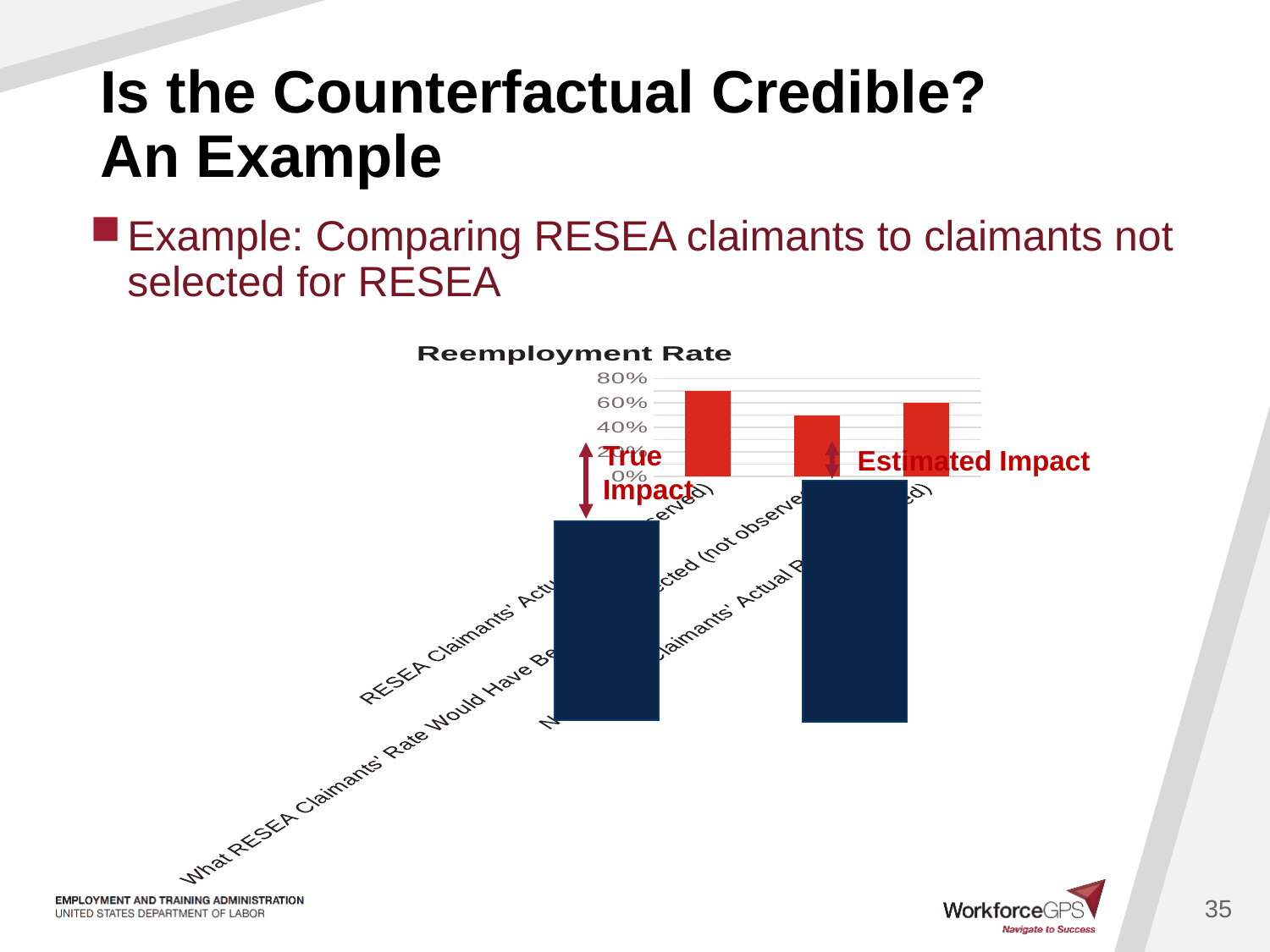
In the Reemployment Rate chart, which is larger: the leftmost bar or the middle bar? the leftmost bar In the Reemployment Rate chart, is the value of the middle bar greater or less than 60%? less In the Reemployment Rate chart, which bar is the shortest: the leftmost, the middle, or the rightmost? the middle In the Reemployment Rate chart, is the value of the middle bar greater or less than 40%? greater What colour are the bars in the Reemployment Rate chart? red What kind of chart is shown on the slide? bar chart In the Reemployment Rate chart, is the value of the leftmost bar greater or less than 60%? greater How many bars are plotted in the Reemployment Rate chart? 3 What is the title of the chart on the slide? Reemployment Rate In the Reemployment Rate chart, which bar is the tallest: the leftmost, the middle, or the rightmost? the leftmost In the Reemployment Rate chart, does the value fall or rise from the leftmost bar to the middle bar? fall